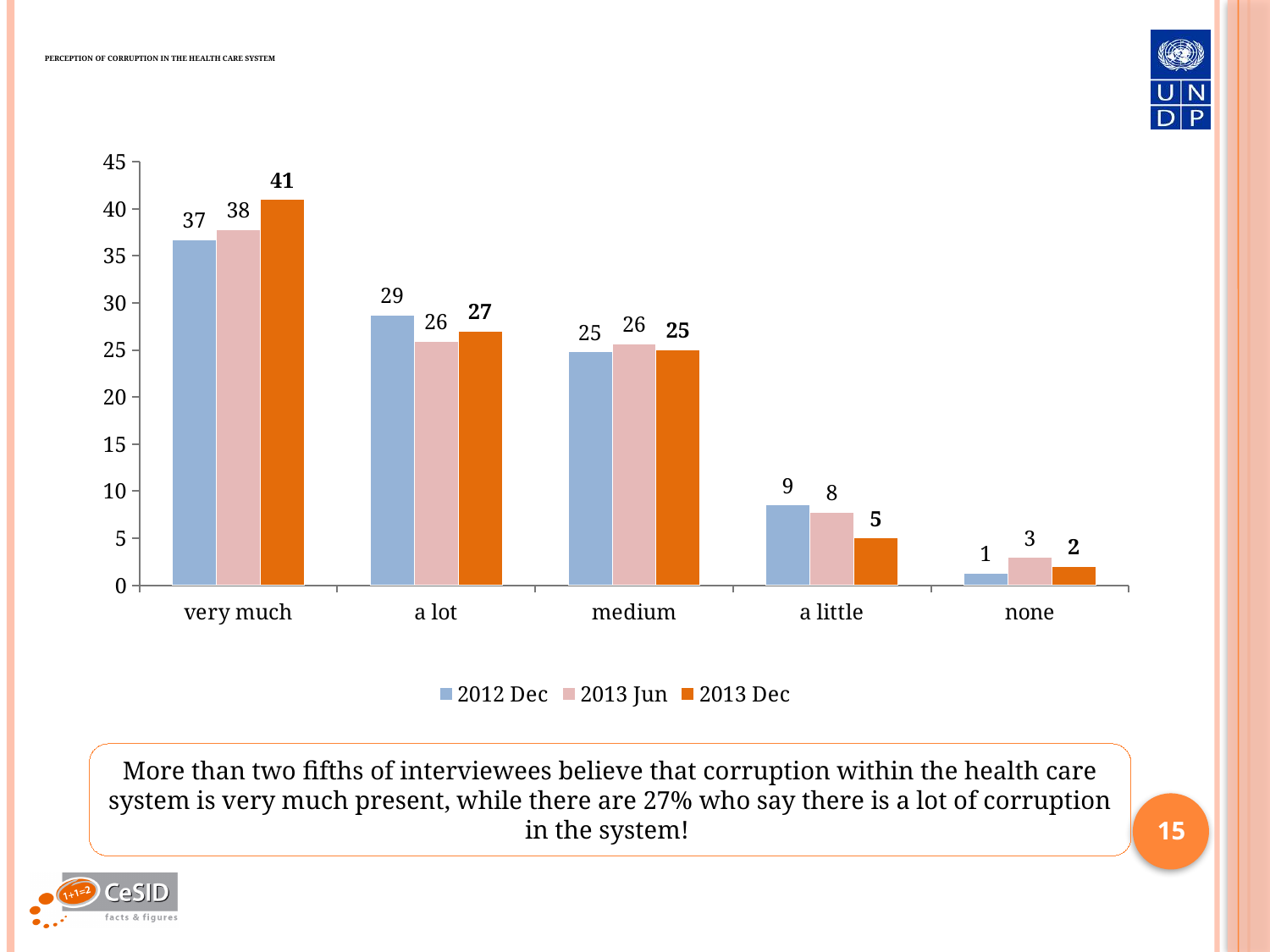
What is the value for 'a lot' in the 2012 Dec series? 29 Which category has the lowest value in the 2012 Dec series? none What kind of chart is shown on the slide? bar chart Do the 2013 Dec values rise or fall moving from 'very much' to 'none' along the x axis? fall What is the title printed at the top of the slide? PERCEPTION OF CORRUPTION IN THE HEALTH CARE SYSTEM Which is larger for 'a little': the 2012 Dec value or the 2013 Dec value? 2012 Dec How many series does the legend list? 3 What is the value for 'very much' in the 2013 Dec series? 41 Which category has the highest value in the 2013 Dec series? very much What is the difference between the 2013 Dec and 2012 Dec values for 'very much'? 4 What is the value for 'none' in the 2013 Jun series? 3 How many categories are shown on the x axis? 5